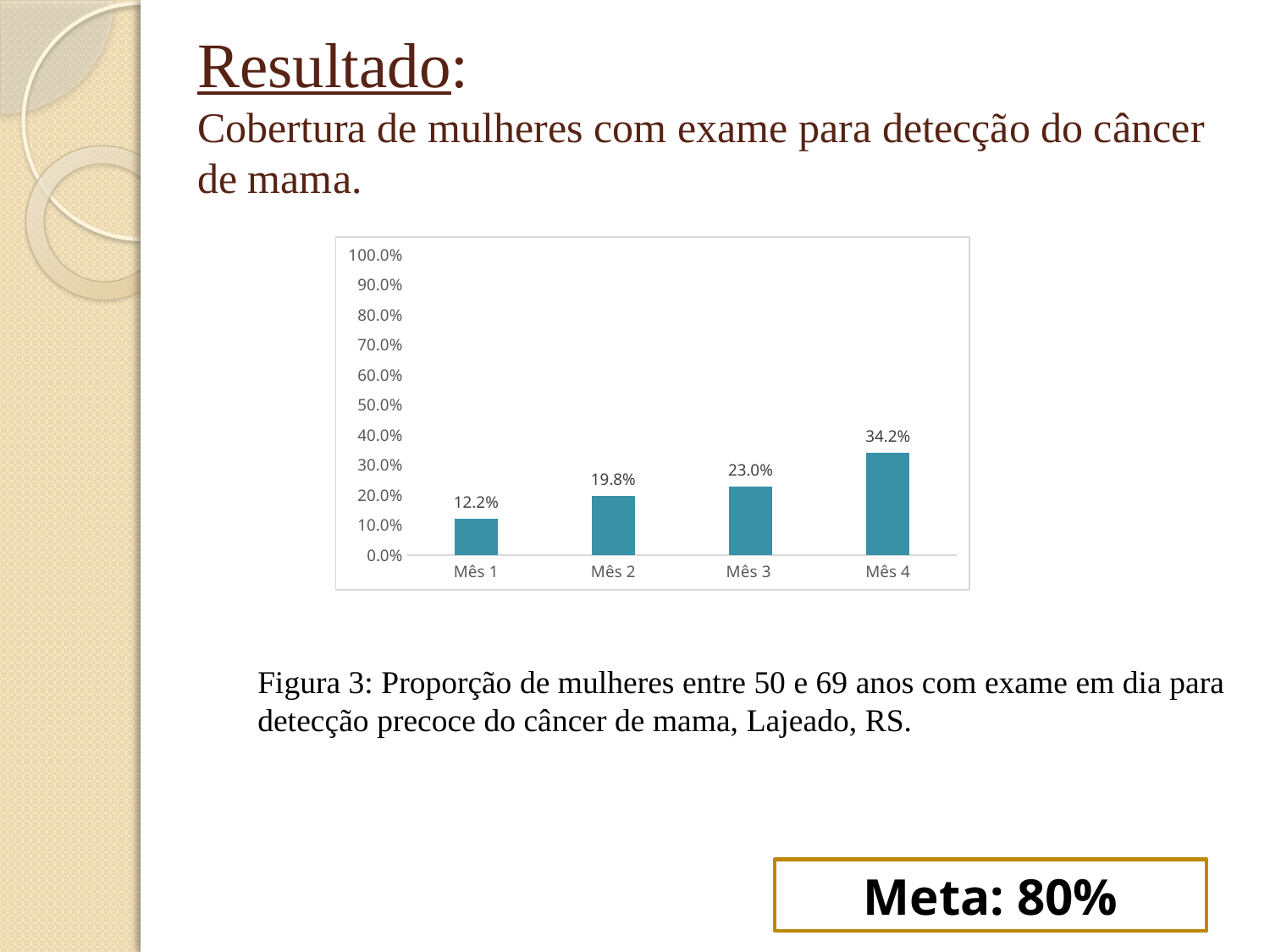
Which month has the lowest value? Mês 1 Do the values rise or fall from Mês 1 to Mês 4? rise Which month has the highest value? Mês 4 What kind of chart is shown on the slide? bar chart What is the difference between the values for Mês 4 and Mês 1? 22.0% Is the value for Mês 4 greater or less than 80.0%? less What is the value for Mês 3? 23.0% What is the value for Mês 1? 12.2% What is the value for Mês 4? 34.2% How many months are shown on the x axis? 4 What is the value for Mês 2? 19.8% Which is larger, the value for Mês 2 or the value for Mês 3? Mês 3